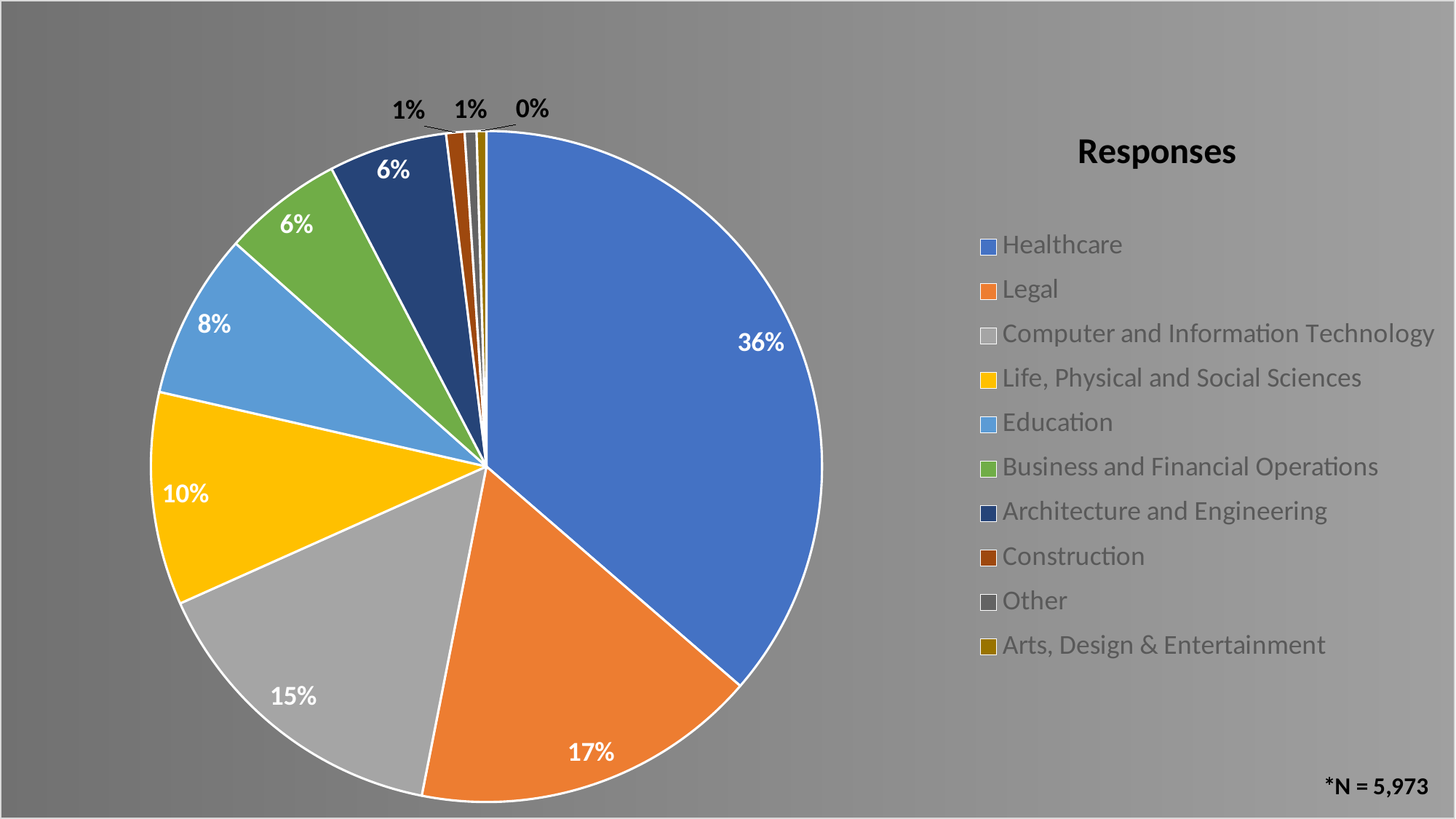
What is the title of the chart? Responses What kind of chart is shown on the slide? pie chart Which has a larger share, Life, Physical and Social Sciences or Education? Life, Physical and Social Sciences What share of responses is Computer and Information Technology? 15% How many categories does the legend list? 10 What share of responses is Construction? 1% What share of responses is Education? 8% Which category has the smallest share of responses? Arts, Design & Entertainment Which category has the largest share of responses? Healthcare What is the difference in percentage points between Healthcare and Legal? 19